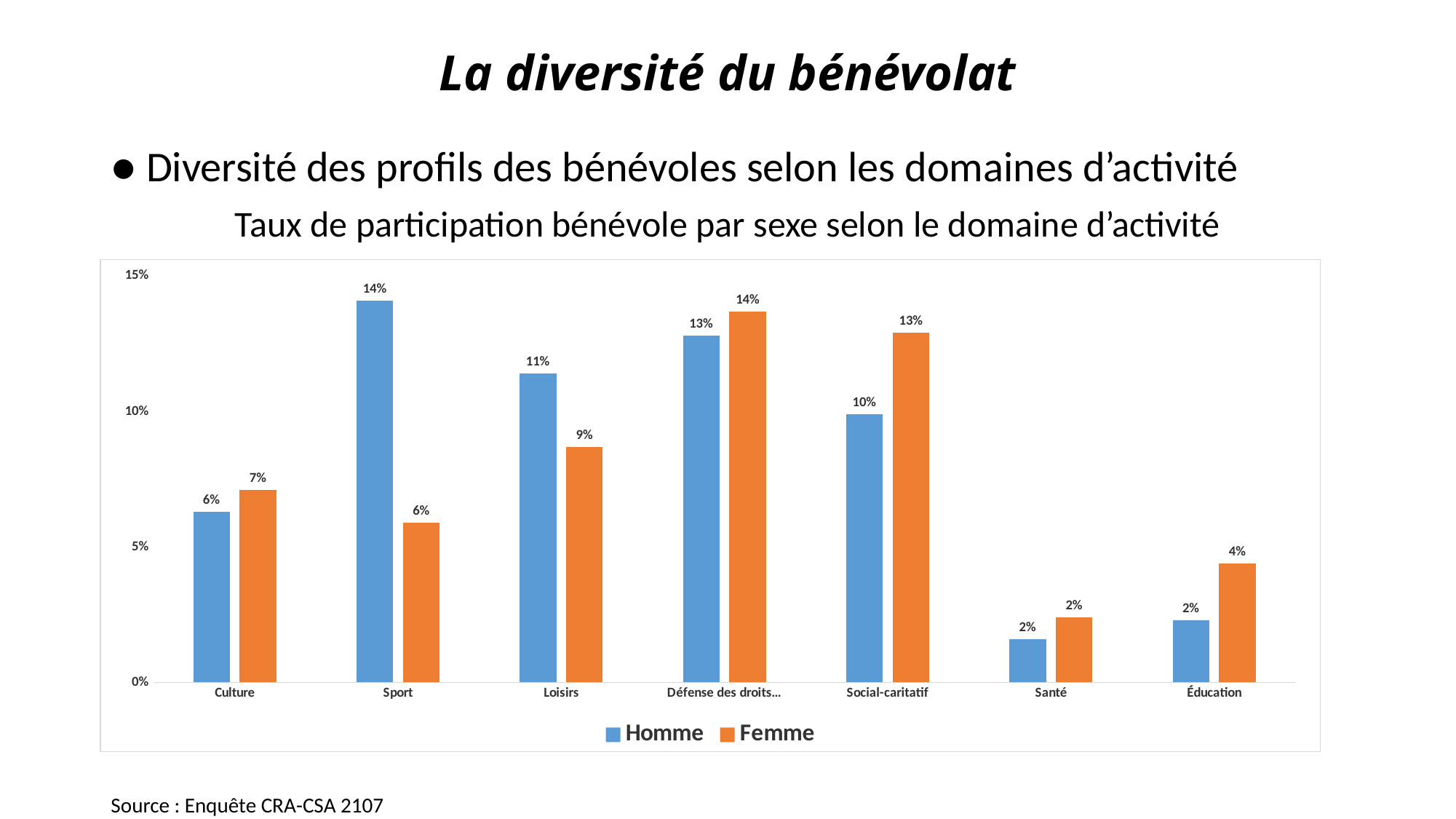
What kind of chart is shown on the slide? Bar chart In the Social-caritatif category, which is larger, the Homme value or the Femme value? Femme Which category has the lowest value for the Femme series? Santé What is the value for Homme in the Sport category? 14% How many categories are shown on the x axis? 7 What is the value for Femme in the Éducation category? 4% Which category has the highest value for the Homme series? Sport Which category has the highest value for the Femme series? Défense des droits... What is the value for Femme in the Social-caritatif category? 13% Is the value for Homme in the Loisirs category greater or less than 10%? greater How many series does the legend list? 2 What is the difference between the Homme and Femme values in the Sport category? 8 percentage points